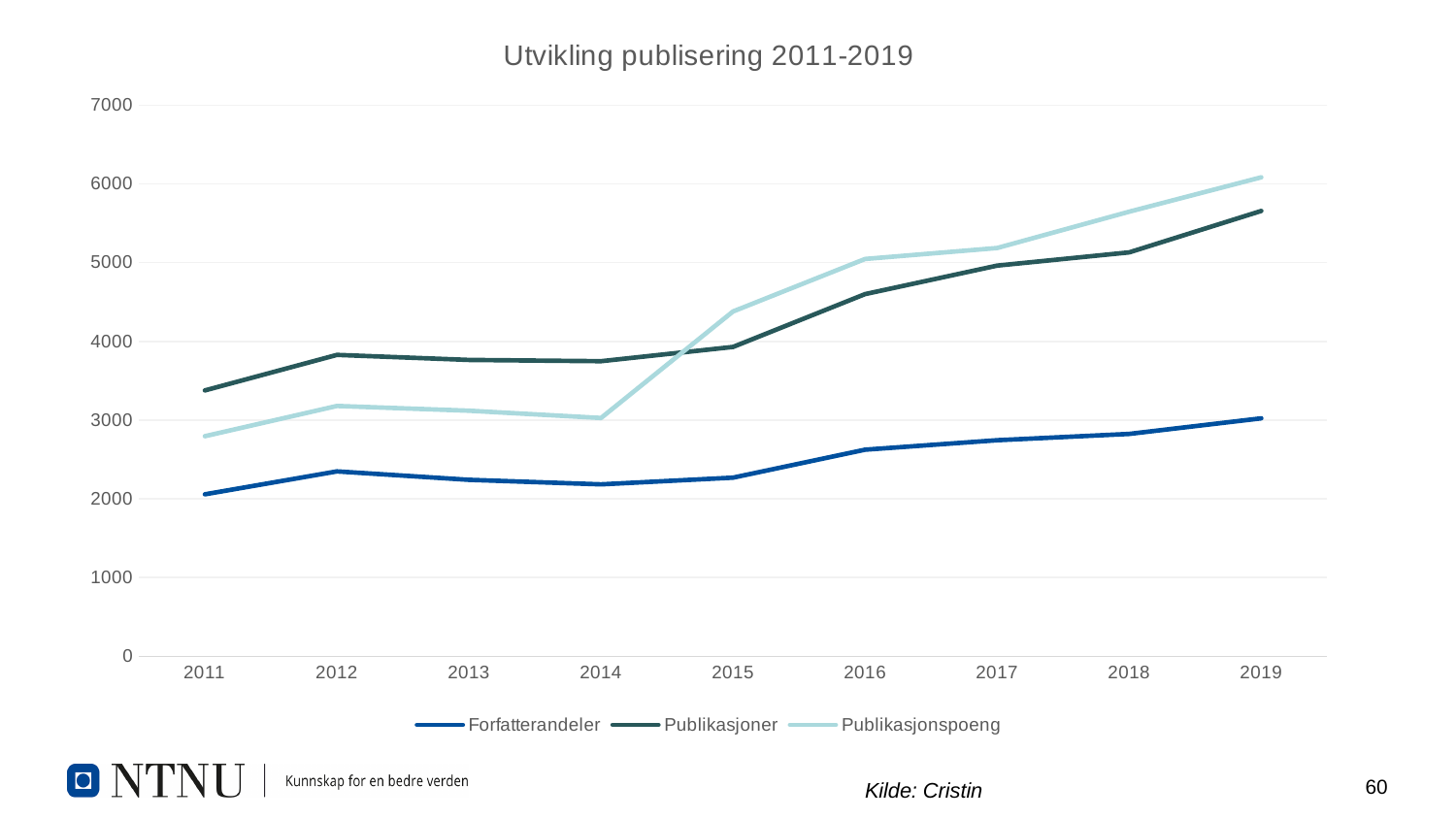
What is the title of the chart? Utvikling publisering 2011-2019 What kind of chart is shown on the slide? Line chart Does the Publikasjoner series overall rise or fall from 2011 to 2019? Rise In which year does Publikasjonspoeng reach its highest value? 2019 Is the value for Publikasjoner in 2011 greater or less than 4000? less In 2011, which is larger: Publikasjoner or Publikasjonspoeng? Publikasjoner Is the value for Publikasjonspoeng in 2011 greater or less than 3000? less Which series is drawn with the lightest line colour? Publikasjonspoeng How many series does the legend list? 3 Is the value for Publikasjonspoeng in 2019 greater or less than 5000? greater In 2019, which is larger: Publikasjoner or Publikasjonspoeng? Publikasjonspoeng How many years are plotted along the x axis? 9